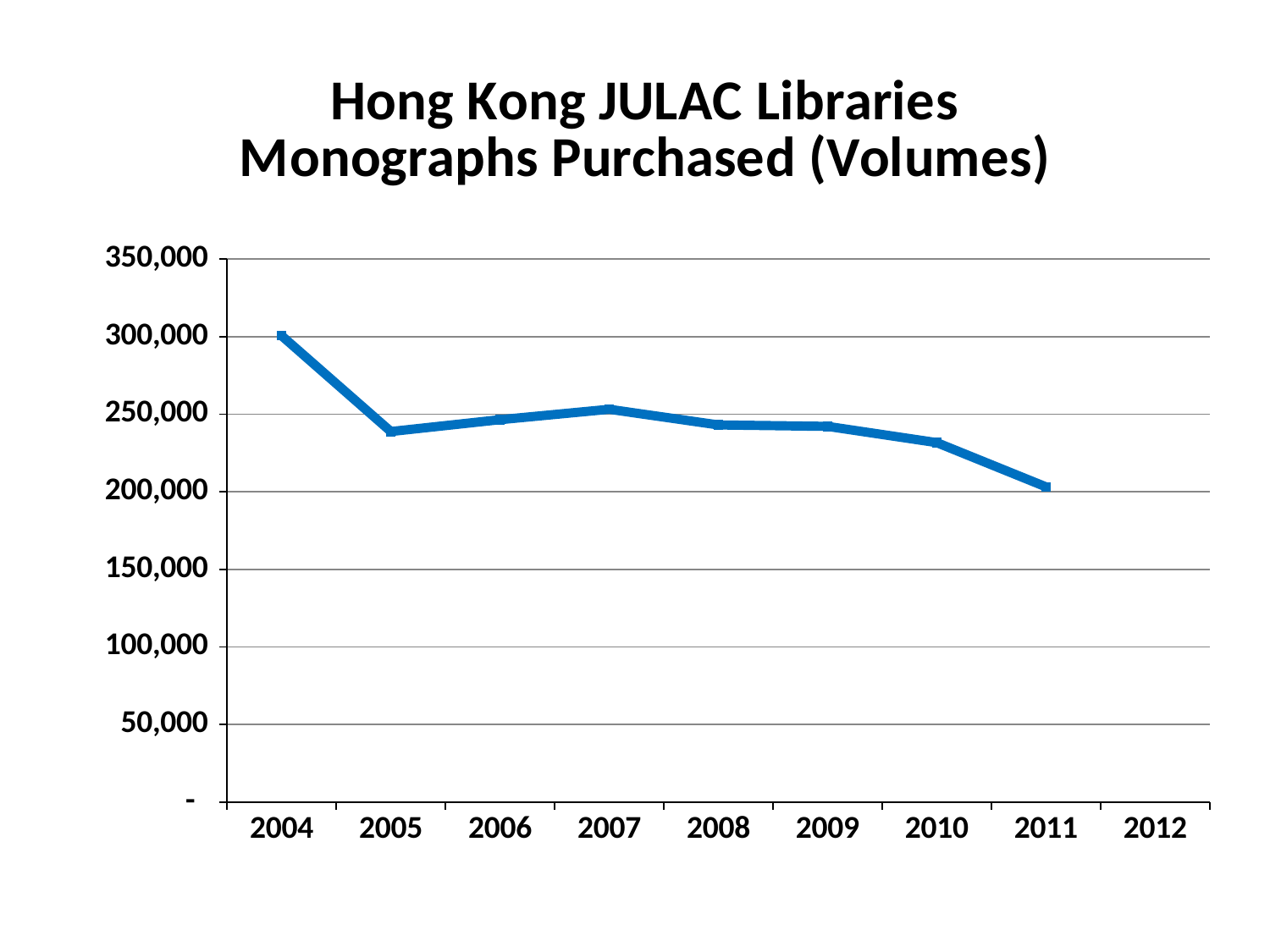
Overall, do the values rise or fall from 2004 to 2011? fall Is the value for 2004 greater or less than 250,000? greater Which year has the larger value, 2007 or 2005? 2007 Is the value for 2011 greater or less than 250,000? less How many years have a data point plotted on the line? 8 Which year has the lowest number of monographs purchased? 2011 What is the title of the chart? Hong Kong JULAC Libraries Monographs Purchased (Volumes) Which year has the larger value, 2004 or 2011? 2004 What kind of chart is shown on the slide? line chart Is the value for 2005 greater or less than 250,000? less Which year has the highest number of monographs purchased? 2004